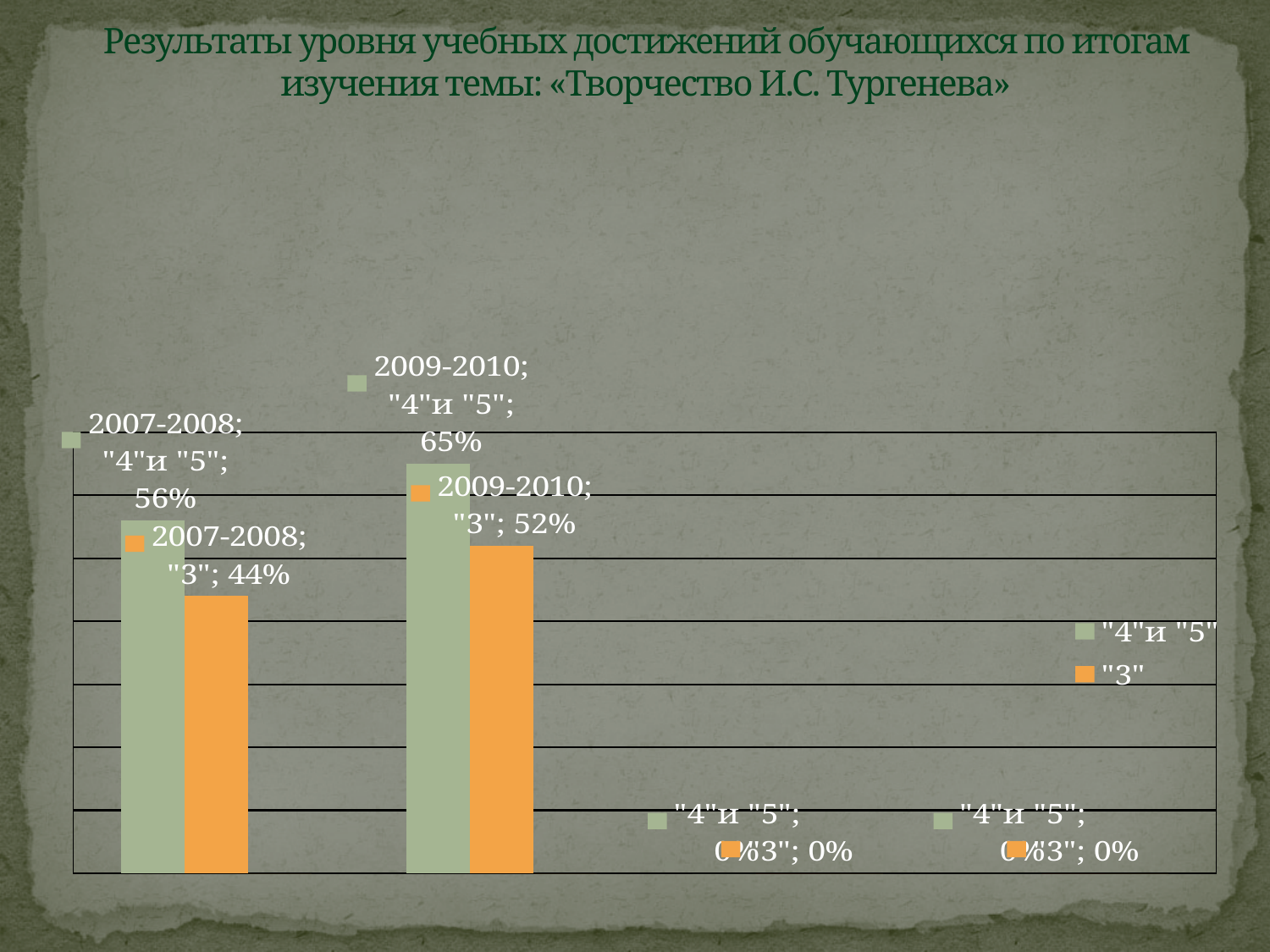
What is the difference between the "4" и "5" values for 2009-2010 and 2007-2008? 9% What is the difference between the "4" и "5" value and the "3" value in 2009-2010? 13% What is the value for "3" in 2007-2008? 44% Which colour represents the "3" series in the chart? Orange What is the difference between the "4" и "5" value and the "3" value in 2007-2008? 12% What is the value for "3" in 2009-2010? 52% What is the value for "4" и "5" in 2007-2008? 56% What kind of chart is shown on the slide? Bar chart Which year has the higher value for "3", 2007-2008 or 2009-2010? 2009-2010 How many series does the legend list? 2 What is the value for "4" и "5" in 2009-2010? 65% Which year has the higher value for "4" и "5", 2007-2008 or 2009-2010? 2009-2010